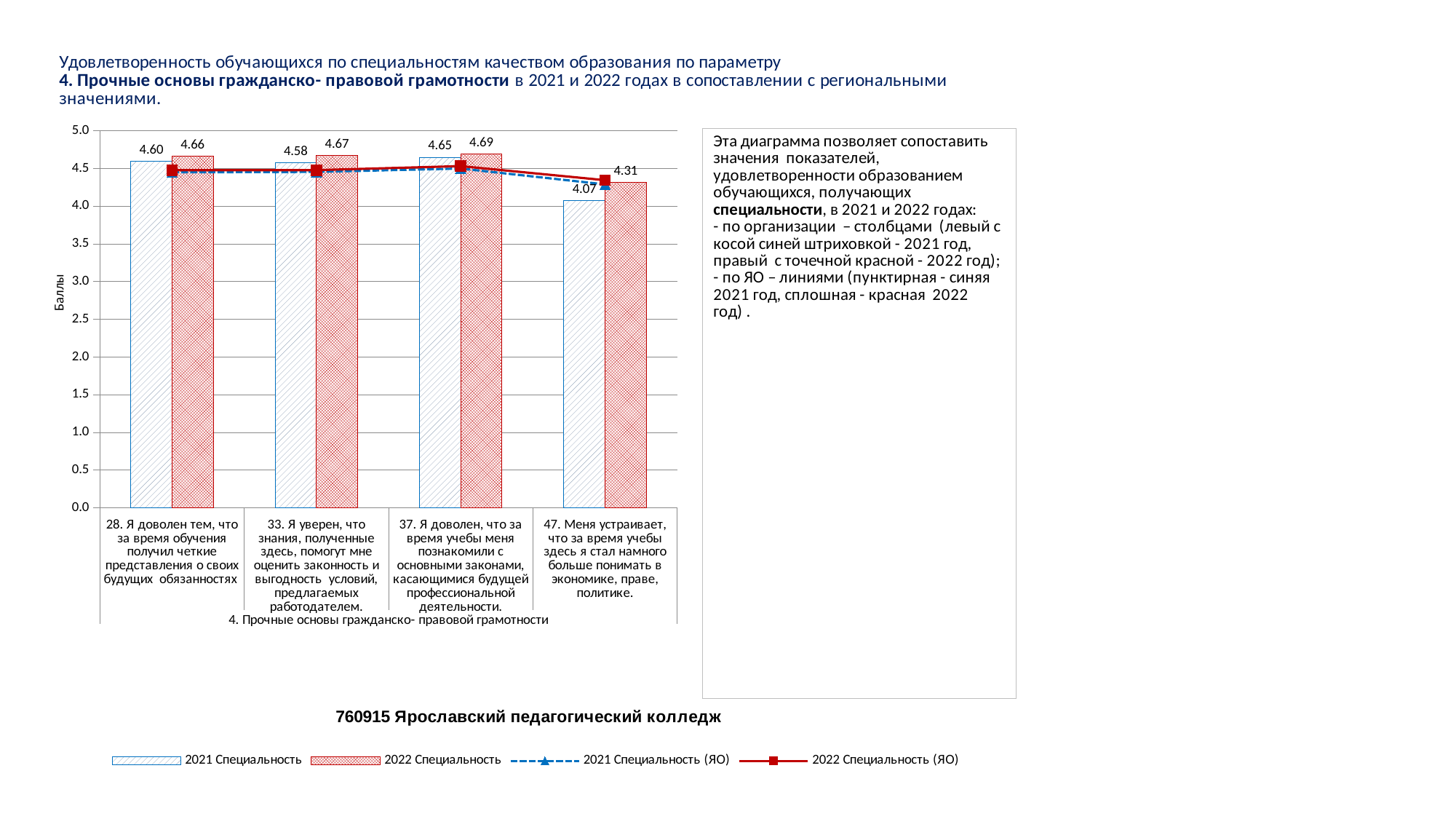
Which item has the highest 2022 Специальность bar? 37. Я доволен, что за время учебы меня познакомили с основными законами, касающимися будущей профессиональной деятельности. What is the difference between the 2022 and 2021 Специальность bars for item 47? 0.24 How many question items (categories) are shown on the x axis? 4 Which item has the lowest 2021 Специальность bar? 47. Меня устраивает, что за время учебы здесь я стал намного больше понимать в экономике, праве, политике. What is the value of the 2021 Специальность bar for item 47 (Меня устраивает, что за время учебы здесь я стал намного больше понимать в экономике, праве, политике)? 4.07 What kind of chart is this? Combined bar and line chart What is the value of the 2022 Специальность bar for item 33 (Я уверен, что знания, полученные здесь, помогут мне оценить законность и выгодность условий, предлагаемых работодателем)? 4.67 How many series does the legend list? 4 Is the 2021 Специальность value for item 47 greater or less than 4.5? less What is the value of the 2021 Специальность bar for item 28 (Я доволен тем, что за время обучения получил четкие представления о своих будущих обязанностях)? 4.60 For item 37, which bar is larger: 2021 Специальность or 2022 Специальность? 2022 Специальность What is the label of the vertical axis? Баллы